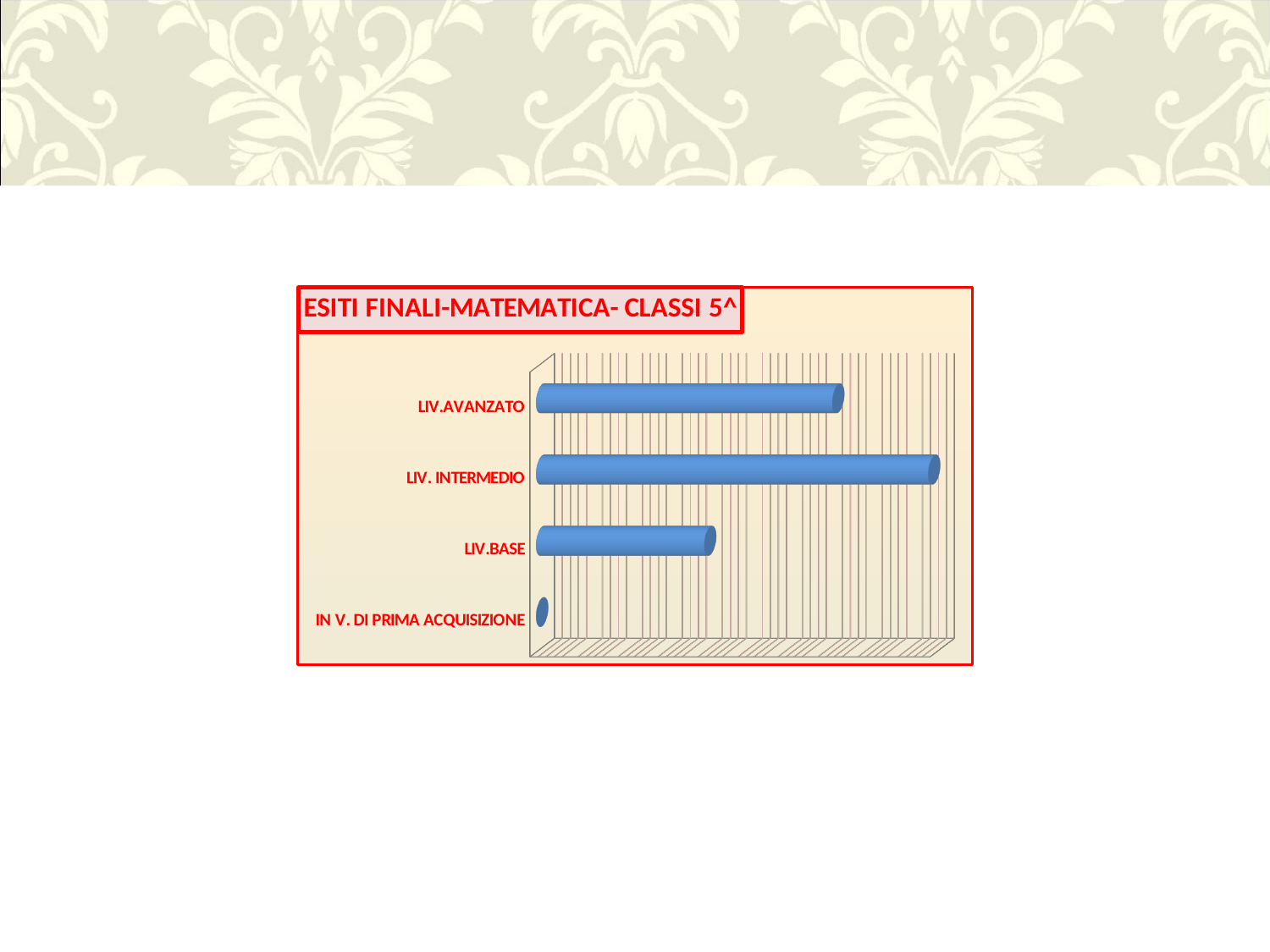
Which is larger, the value for LIV. INTERMEDIO or the value for LIV.AVANZATO? LIV. INTERMEDIO What is the title of the chart? ESITI FINALI-MATEMATICA- CLASSI 5^ What colour are the bars in the chart? blue Which category has the highest value in the chart? LIV. INTERMEDIO What kind of chart is shown on the slide? bar chart Which category has the lowest value in the chart? IN V. DI PRIMA ACQUISIZIONE Which category has the second-longest bar in the chart? LIV.AVANZATO How many categories are plotted in the chart? 4 Which is larger, the value for LIV.BASE or the value for IN V. DI PRIMA ACQUISIZIONE? LIV.BASE